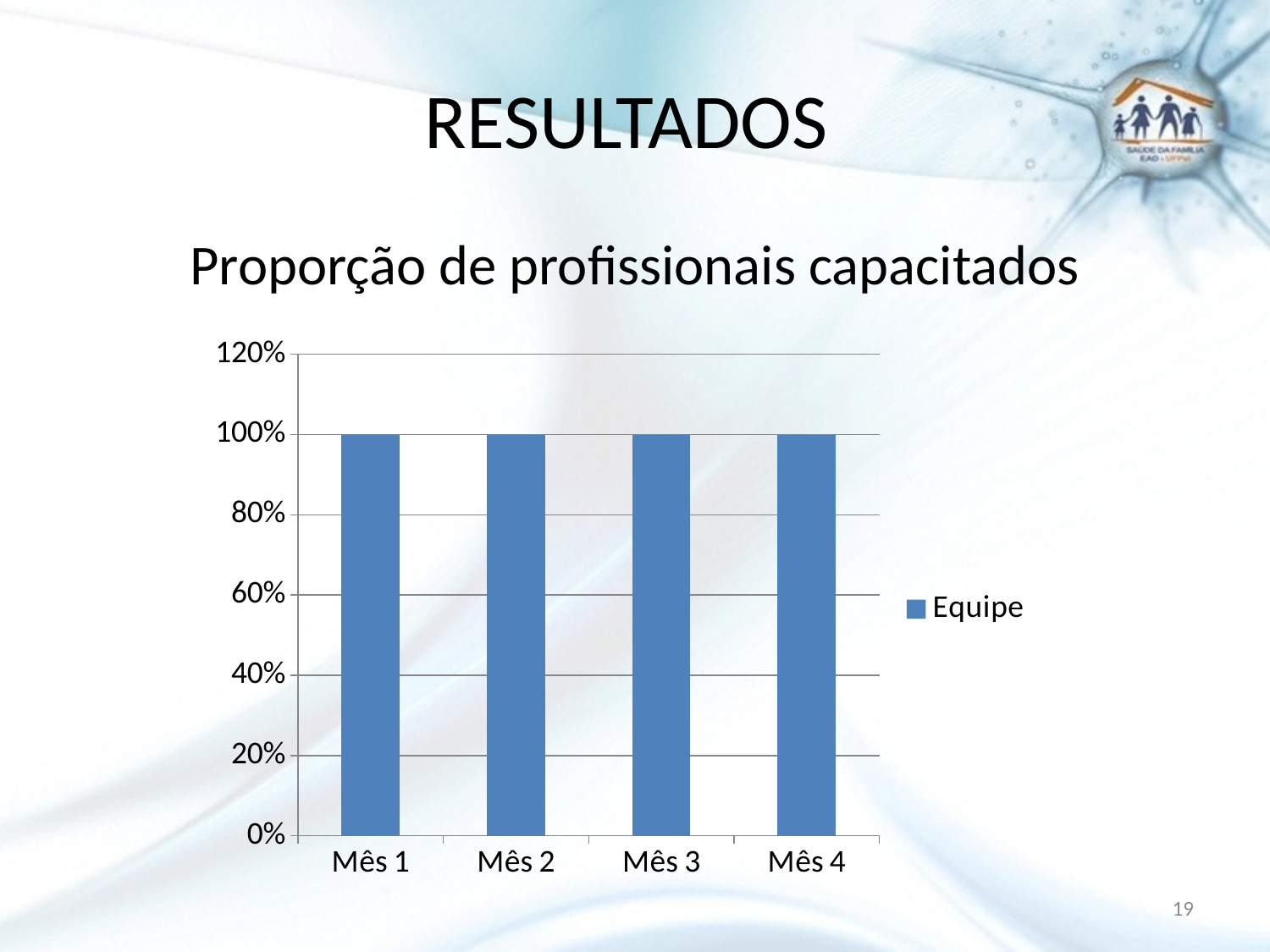
Is the value for Mês 4 greater or less than 120%? less What is the value for Mês 1? 100% What is the difference between the values for Mês 1 and Mês 4? 0% How many categories are shown on the x axis of the chart? 4 What type of chart is shown on the slide? bar chart How many series does the chart legend list? 1 What is the title of the chart? Proporção de profissionais capacitados What series name appears in the chart legend? Equipe What is the value for Mês 3? 100% Is the value for Mês 2 greater or less than 80%? greater What is the value for Mês 4? 100% Do the values rise, fall, or stay the same from Mês 1 to Mês 4? stay the same